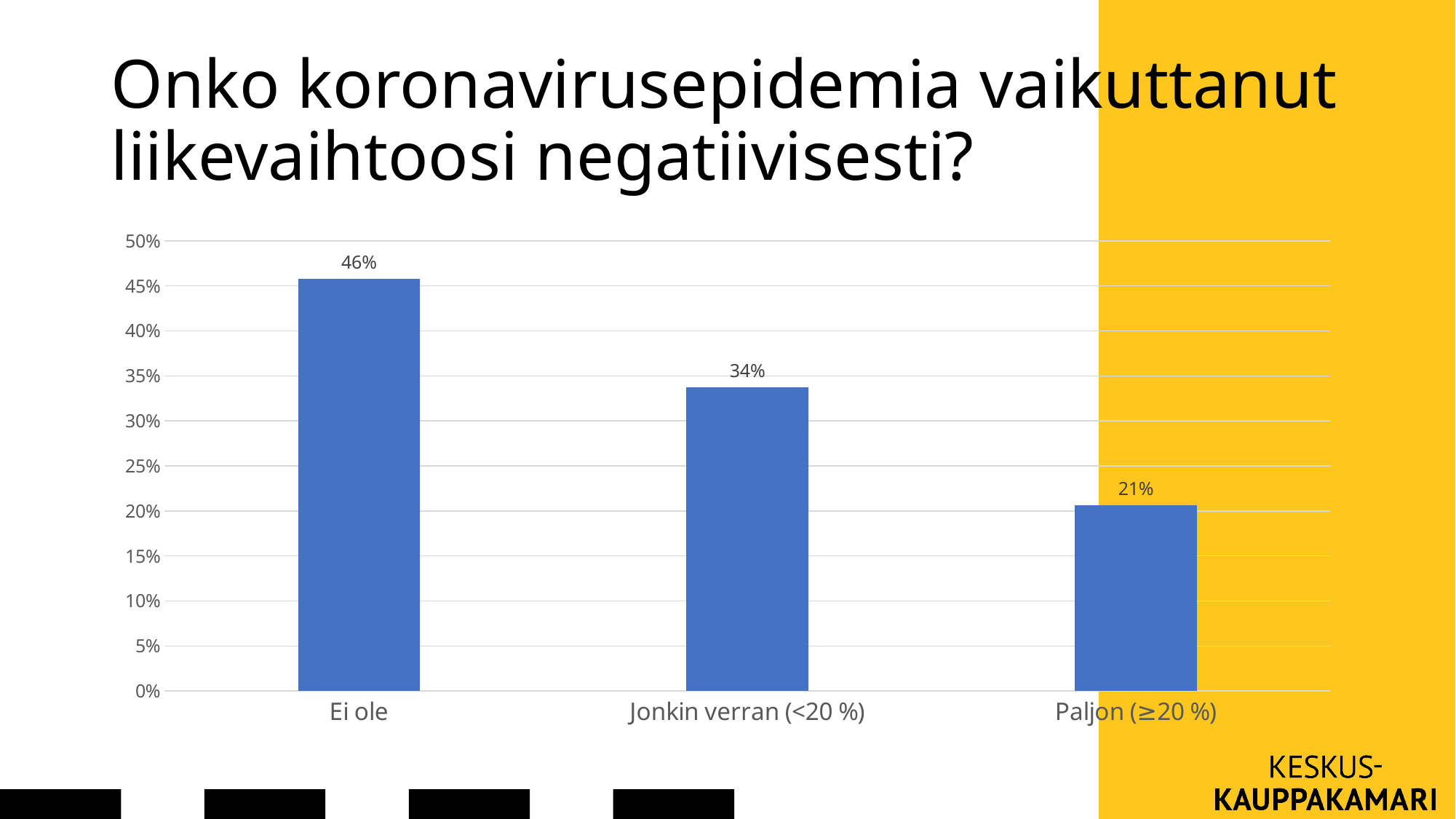
What is the value for "Jonkin verran (<20 %)"? 34% Which is larger, the value for "Jonkin verran (<20 %)" or the value for "Paljon (≥20 %)"? Jonkin verran (<20 %) Which category has the highest value? Ei ole Do the values rise or fall from left to right along the x axis? Fall What is the value for "Ei ole"? 46% What kind of chart is shown on the slide? Bar chart Is the value for "Jonkin verran (<20 %)" greater or less than 30%? greater Which category has the lowest value? Paljon (≥20 %) What is the value for "Paljon (≥20 %)"? 21% How many categories are shown on the x axis? 3 What is the difference between the values for "Ei ole" and "Jonkin verran (<20 %)"? 12% What is the difference between the values for "Ei ole" and "Paljon (≥20 %)"? 25%